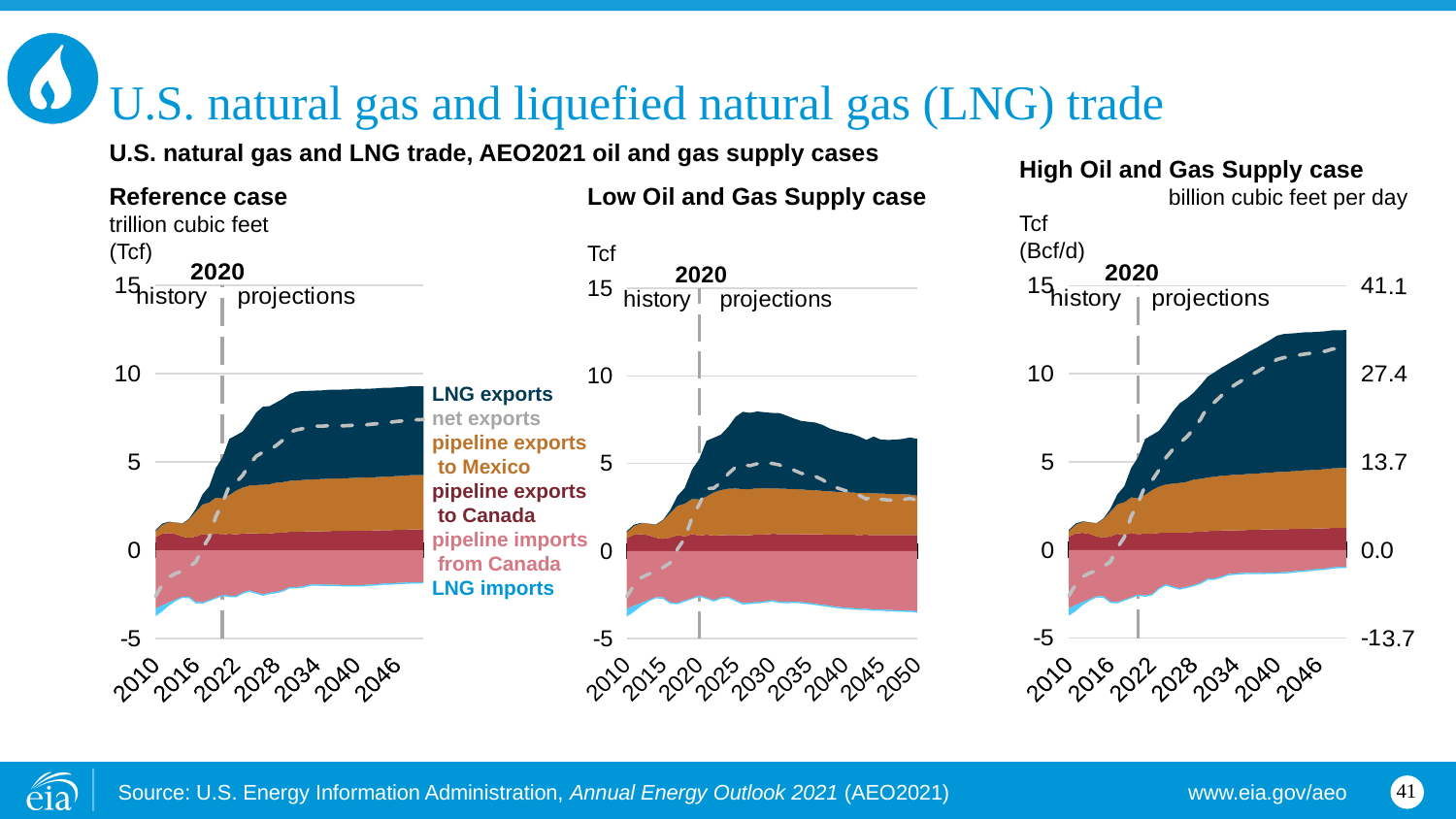
In the High Oil and Gas Supply case chart, do net exports rise or fall over the projection period from 2020 to 2050? rise How many charts are shown on the slide? 3 In the High Oil and Gas Supply case chart, what value on the right-hand axis corresponds to 15 Tcf? 41.1 How many entries does the legend between the Reference case and Low Oil and Gas Supply case charts list? 6 In the Reference case chart, is the net exports value in 2046 greater or less than 5 Tcf? greater In the High Oil and Gas Supply case chart, what value on the right-hand axis (billion cubic feet per day) corresponds to 10 Tcf on the left axis? 27.4 Which case shows higher net exports in 2046: the Reference case or the High Oil and Gas Supply case? High Oil and Gas Supply case In the Low Oil and Gas Supply case chart, is the net exports value in 2050 greater or less than 5 Tcf? less What kind of chart is the Reference case chart? combination stacked area and line chart In the High Oil and Gas Supply case chart, is the net exports value in 2046 greater or less than 10 Tcf? greater In which year does the vertical dashed line separating history from projections fall in each chart? 2020 In the High Oil and Gas Supply case chart, what value on the right-hand axis corresponds to -5 Tcf? -13.7